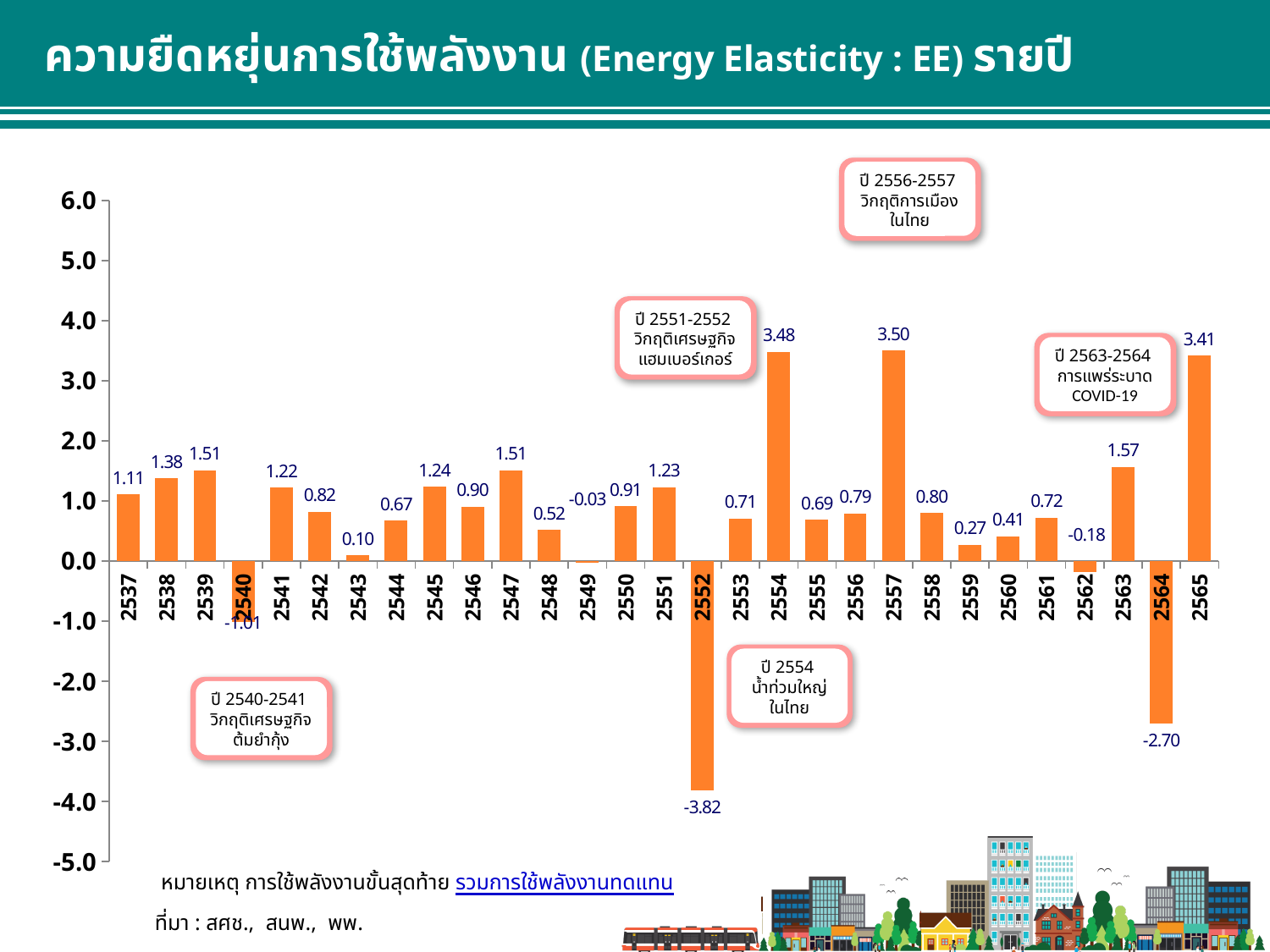
What is the difference between the energy elasticity values for 2557 and 2554? 0.02 Which year has the lowest energy elasticity value? 2552 What is the energy elasticity value for the year 2564? -2.70 What is the difference between the energy elasticity values for 2565 and 2564? 6.11 What event does the annotation for years 2563-2564 refer to? การแพร่ระบาด COVID-19 What is the energy elasticity value for the year 2565? 3.41 What kind of chart is shown on the slide? Bar chart Which year has a larger energy elasticity value, 2563 or 2561? 2563 Which year has the highest energy elasticity value? 2557 What is the energy elasticity value for the year 2540? -1.01 How many years are plotted on the chart? 29 What is the energy elasticity value for the year 2552? -3.82